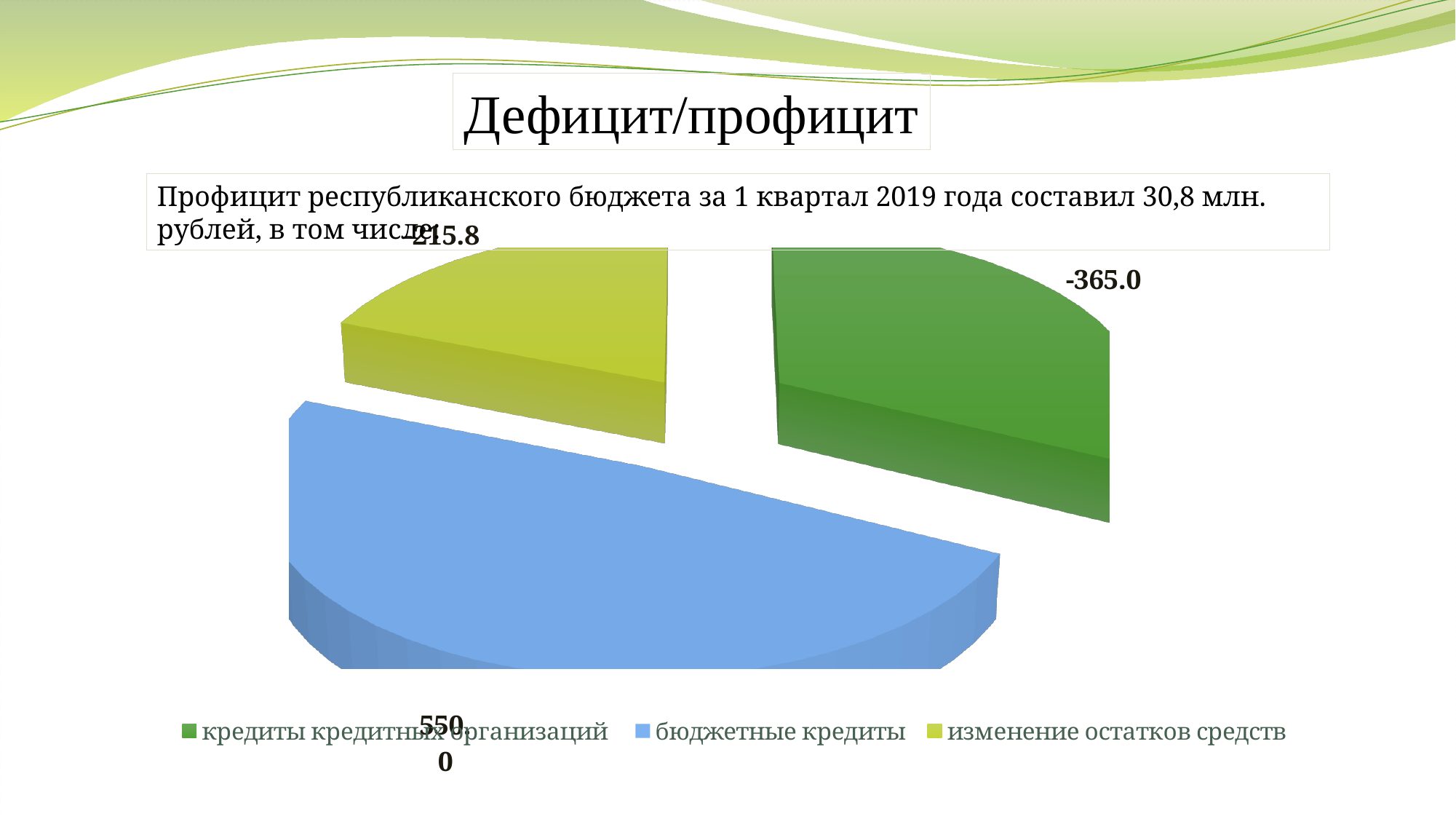
What value is shown for the slice "изменение остатков средств"? -215.8 What is the difference between the values for "бюджетные кредиты" and "изменение остатков средств"? 765.8 What value is shown for the slice "кредиты кредитных организаций"? -365.0 What is the title of the slide? Дефицит/профицит Which is larger: the value for "бюджетные кредиты" or the value for "изменение остатков средств"? бюджетные кредиты Which category has the lowest value in the pie chart? кредиты кредитных организаций How many slices does the pie chart have? 3 What kind of chart is shown on the slide? pie chart What value is shown for the slice "бюджетные кредиты"? 550.0 Which colour represents "бюджетные кредиты" in the pie chart? blue How many entries does the legend list? 3 Which category has the highest value in the pie chart? бюджетные кредиты